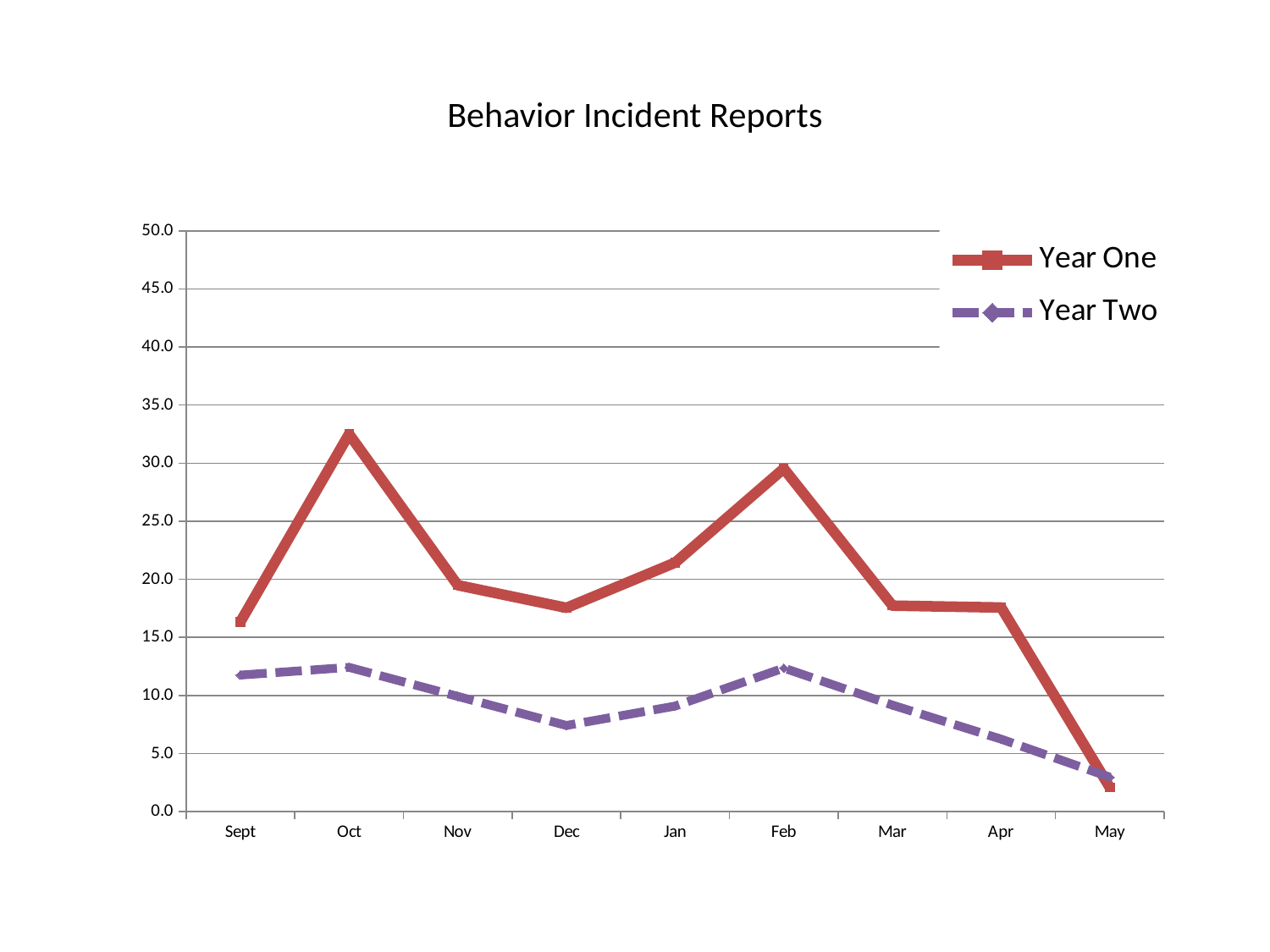
What is the title of the chart? Behavior Incident Reports Is the Year One value for Oct greater or less than 30? greater What kind of chart is shown on the slide? line chart In which month does Year One reach its highest value? Oct How many series does the legend list? 2 In which month does Year Two reach its lowest value? May In Oct, which series has the higher value, Year One or Year Two? Year One Is the Year One value for May greater or less than 5? less Is the Year Two value for Dec greater or less than 10? less In which month does Year One reach its lowest value? May How many months are shown on the x axis? 9 Does the Year Two line rise or fall from Feb to May? fall